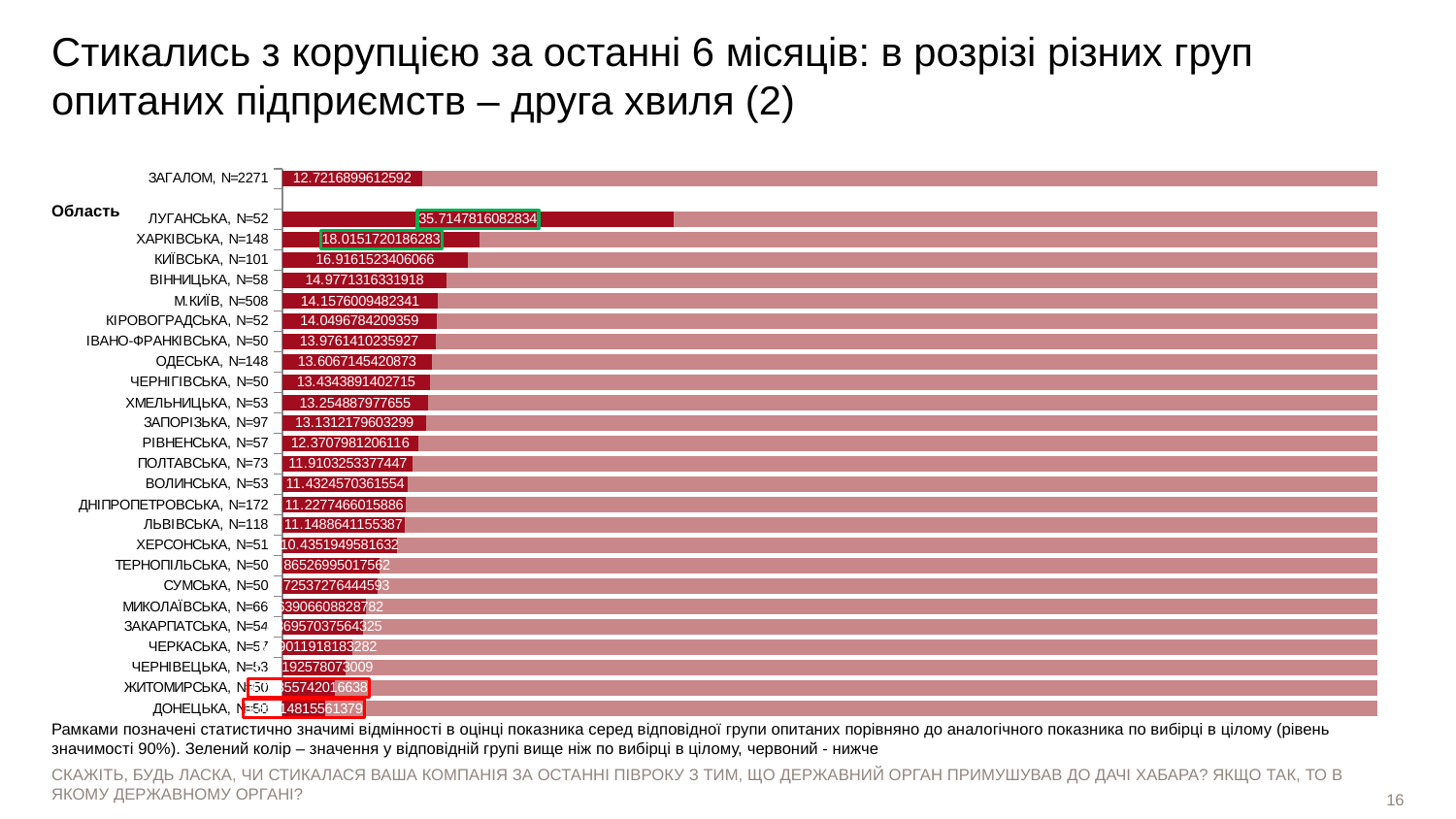
What is the difference between the values for ХАРКІВСЬКА, N=148 and КИЇВСЬКА, N=101? 1.0990196780217 What is the value for ХАРКІВСЬКА, N=148? 18.0151720186283 What is the value for М.КИЇВ, N=508? 14.1576009482341 What is the value for ЗАГАЛОМ, N=2271? 12.7216899612592 What is the value for ОДЕСЬКА, N=148? 13.6067145420873 Which has a larger value, КИЇВСЬКА, N=101 or ВІННИЦЬКА, N=58? КИЇВСЬКА, N=101 What kind of chart is shown on the slide? Bar chart Which region has the lowest value? ДОНЕЦЬКА, N=50 Which region has the highest value? ЛУГАНСЬКА, N=52 Do the values rise or fall going down the list of regions from ЛУГАНСЬКА to ДОНЕЦЬКА? Fall What is the value for ЛУГАНСЬКА, N=52? 35.7147816082834 Which two regions are marked with a green frame on the chart? ЛУГАНСЬКА and ХАРКІВСЬКА